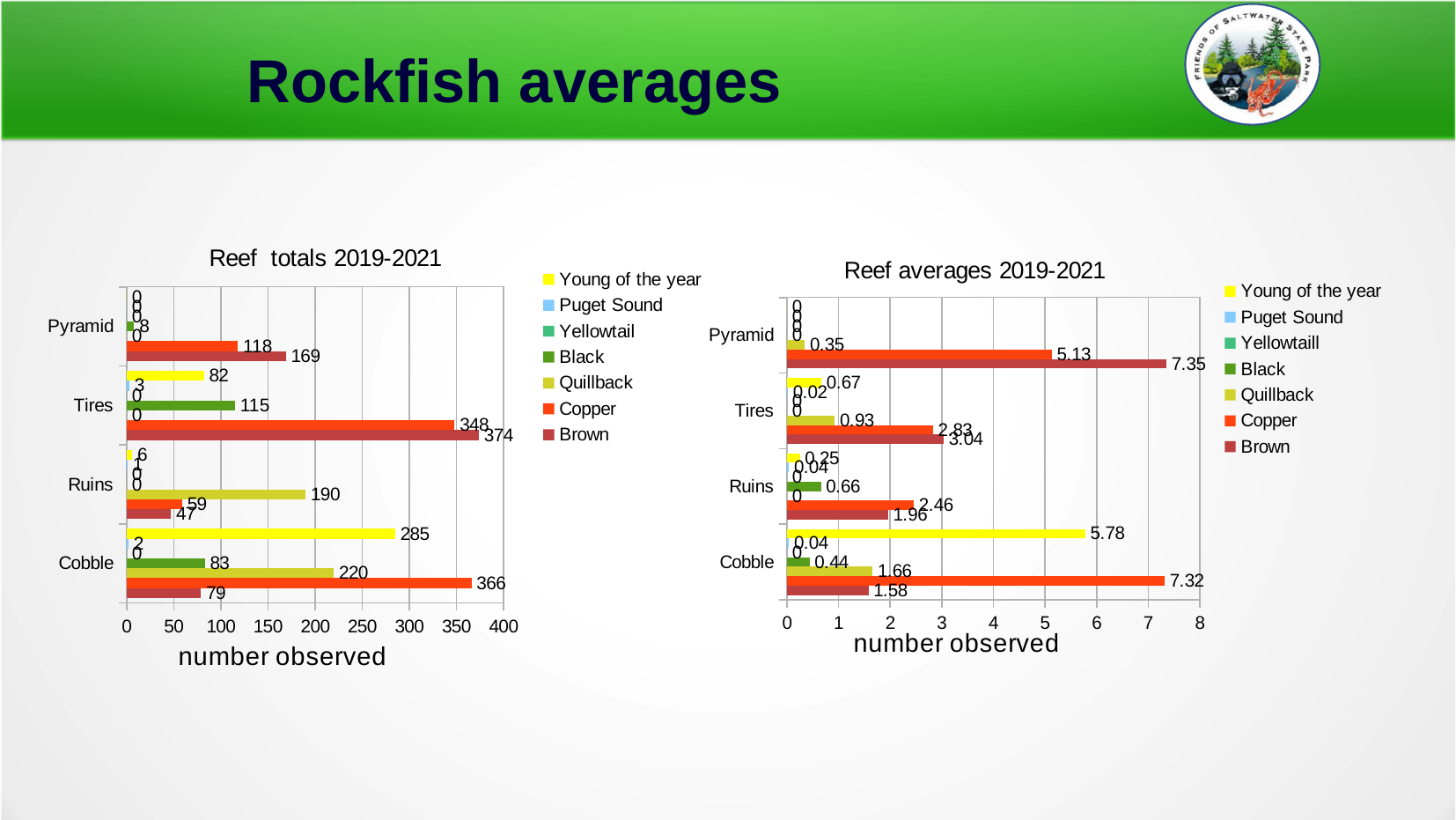
In the Reef totals 2019-2021 chart, which reef has the highest Copper value? Cobble In the Reef averages 2019-2021 chart, which reef has the lowest Brown value? Cobble In the Reef averages 2019-2021 chart, what is the Copper value for Cobble? 7.32 In the Reef totals 2019-2021 chart, which is larger for Ruins, Copper or Brown? Copper What kind of chart is the Reef averages 2019-2021 chart? Bar chart How many series does the legend of the Reef totals 2019-2021 chart list? 7 In the Reef averages 2019-2021 chart, what is the Young of the year value for Cobble? 5.78 In the Reef totals 2019-2021 chart, what is the Copper value for Cobble? 366 In the Reef averages 2019-2021 chart, what is the Brown value for Pyramid? 7.35 In the Reef totals 2019-2021 chart, what is the Young of the year value for Cobble? 285 In the Reef totals 2019-2021 chart, what is the difference between the Brown and Copper values for Tires? 26 In the Reef totals 2019-2021 chart, what is the Brown value for Tires? 374